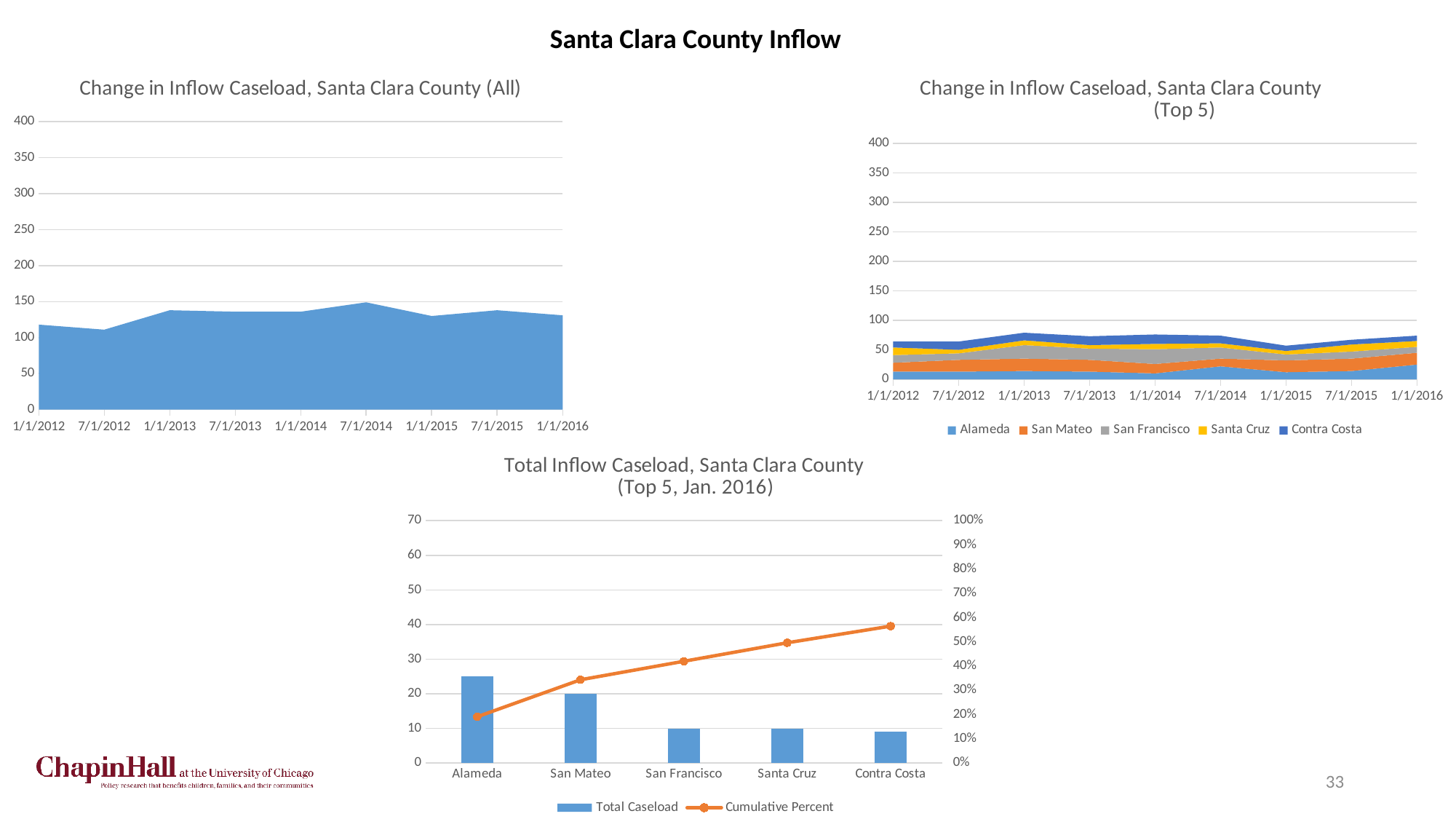
In the chart "Total Inflow Caseload, Santa Clara County (Top 5, Jan. 2016)", is the Cumulative Percent for Contra Costa greater or less than 50%? greater What kind of chart is "Change in Inflow Caseload, Santa Clara County (All)"? Area chart Which counties are listed in the legend of "Change in Inflow Caseload, Santa Clara County (Top 5)"? Alameda, San Mateo, San Francisco, Santa Cruz, Contra Costa In the chart "Total Inflow Caseload, Santa Clara County (Top 5, Jan. 2016)", what is the Total Caseload for San Francisco? 10 How many series does the legend of "Change in Inflow Caseload, Santa Clara County (Top 5)" list? 5 In the chart "Change in Inflow Caseload, Santa Clara County (All)", is the value at 7/1/2012 greater or less than 150? less In the chart "Change in Inflow Caseload, Santa Clara County (All)", is the value at 7/1/2014 greater or less than 100? greater In the chart "Total Inflow Caseload, Santa Clara County (Top 5, Jan. 2016)", what is the Total Caseload for San Mateo? 20 In the chart "Change in Inflow Caseload, Santa Clara County (All)", how many dates are labelled on the x axis? 9 How many counties are shown on the x axis of "Total Inflow Caseload, Santa Clara County (Top 5, Jan. 2016)"? 5 In the chart "Total Inflow Caseload, Santa Clara County (Top 5, Jan. 2016)", which county has the highest Total Caseload bar? Alameda How many series does the legend of "Total Inflow Caseload, Santa Clara County (Top 5, Jan. 2016)" list? 2